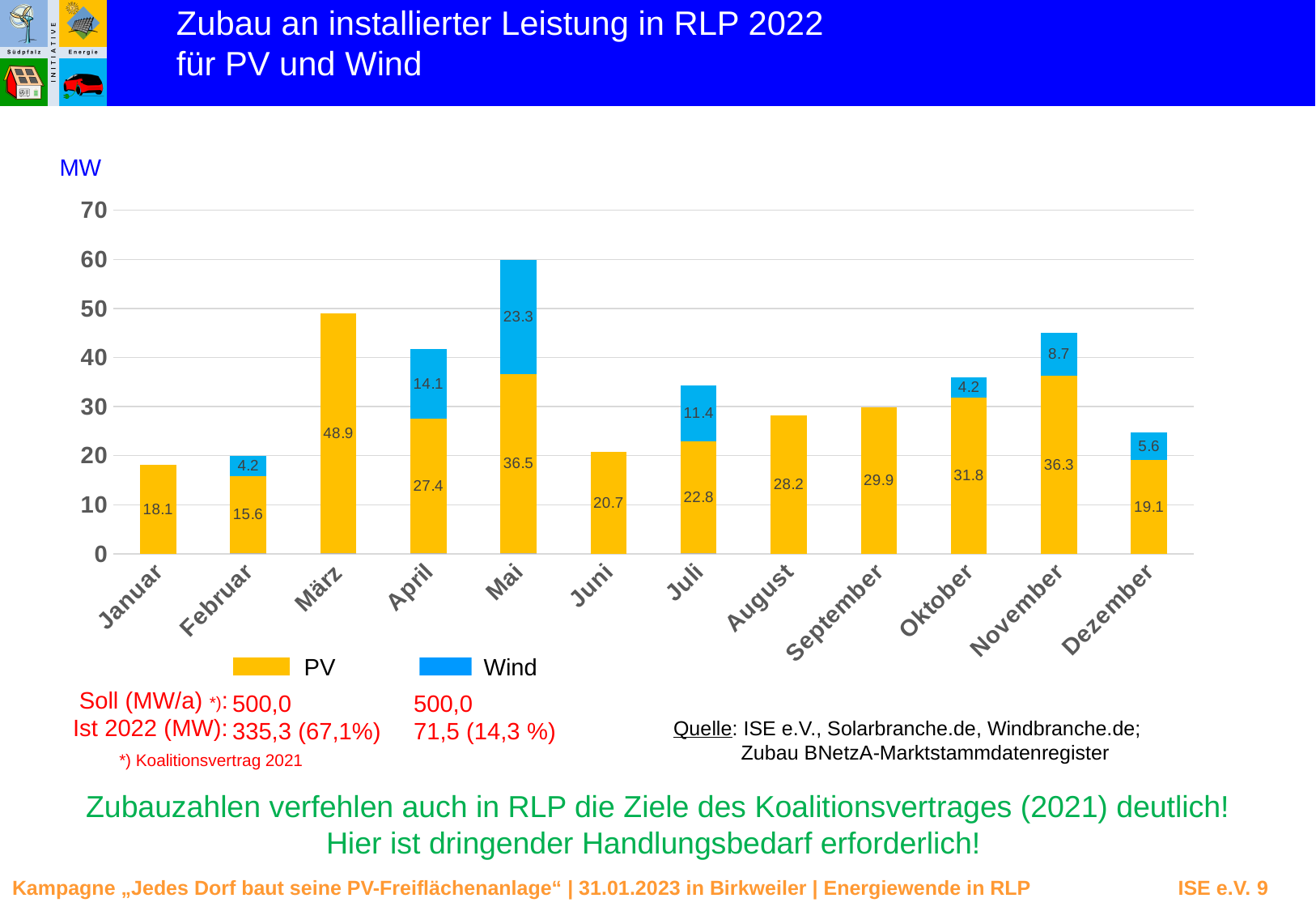
What is the Wind value for Mai? 23.3 What is the difference between the PV values for Oktober and Januar? 13.7 How many series does the legend list? 2 What kind of chart is shown on the slide? Stacked bar chart What is the PV value for März? 48.9 Which month has the lowest PV value? Februar Which is larger, the Wind value for April or the Wind value for Juli? April How many months are shown on the x axis? 12 Which month has the highest PV value? März What is the total of the stacked bar for Dezember? 24.7 What is the PV value for November? 36.3 What is the total of the stacked bar for Mai? 59.8